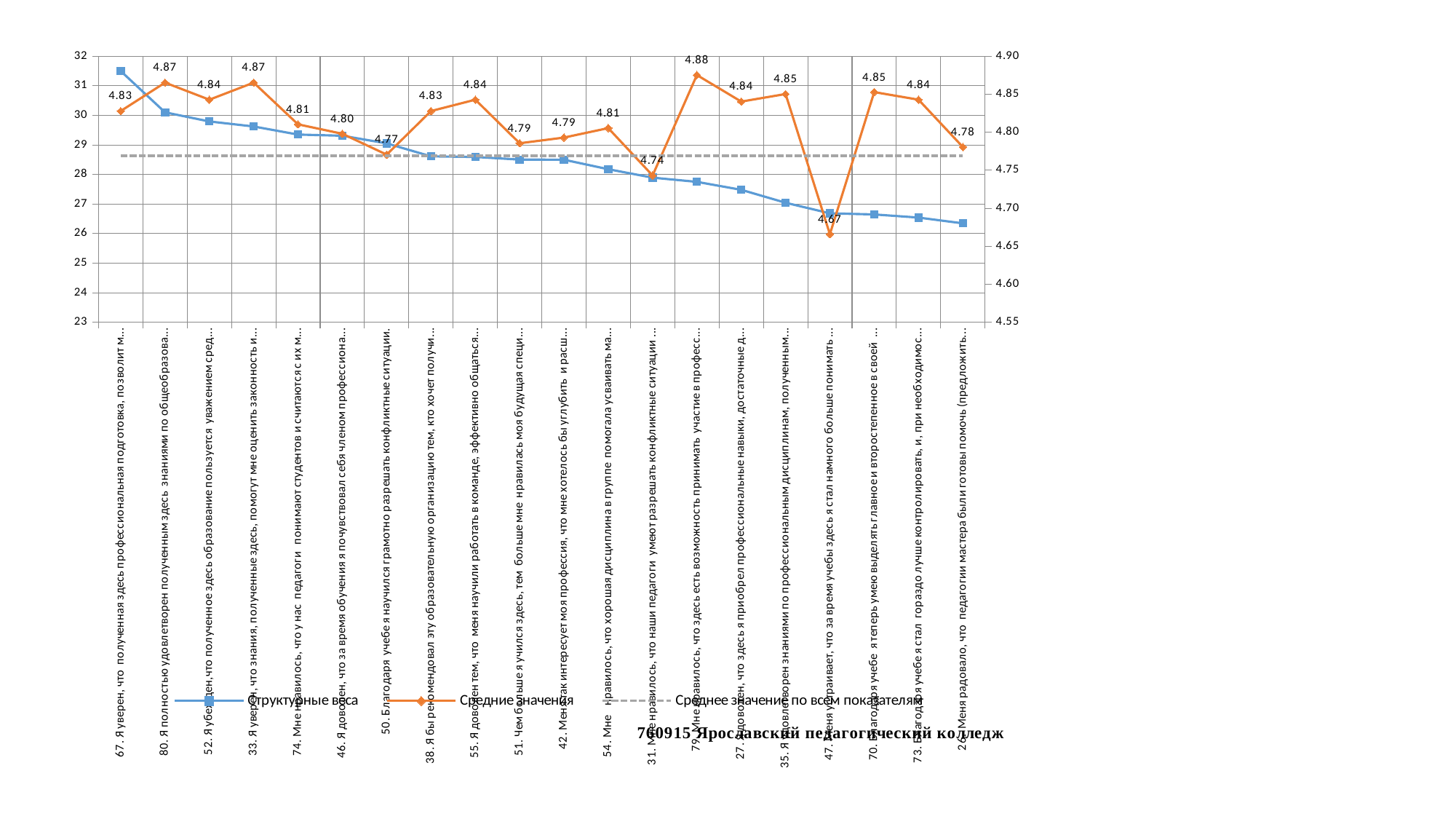
Which category has the highest 'Средние значения' value? 79. Мне нравилось, что здесь есть возможность принимать участие в професс... (4.88) Which is larger: the 'Средние значения' value for the category beginning '31. Мне нравилось, что наши педагоги...' or for the category beginning '79. Мне нравилось, что здесь есть возможность...'? 79. Мне нравилось, что здесь есть возможность... (4.88) What kind of chart is shown on the slide? line chart Is the 'Структурные веса' value for the first category (67. Я уверен...) greater or less than 31 on the left axis? greater Which category has the lowest 'Средние значения' value? 47. Меня устраивает, что за время учебы здесь я стал намного больше понимать... (4.67) What is the value of 'Средние значения' for the category beginning '47. Меня устраивает, что за время учебы здесь я стал намного больше понимать...'? 4.67 How many series does the legend list? 3 How many categories are plotted along the x axis? 20 Do the 'Структурные веса' values rise or fall from left to right along the x axis? fall What is the difference between the highest (4.88) and lowest (4.67) 'Средние значения' values? 0.21 What is the value of 'Средние значения' for the first category (67. Я уверен, что полученная здесь профессиональная подготовка...)? 4.83 What is the value of 'Средние значения' for the last category (26. Меня радовало, что педагоги и мастера были готовы помочь...)? 4.78